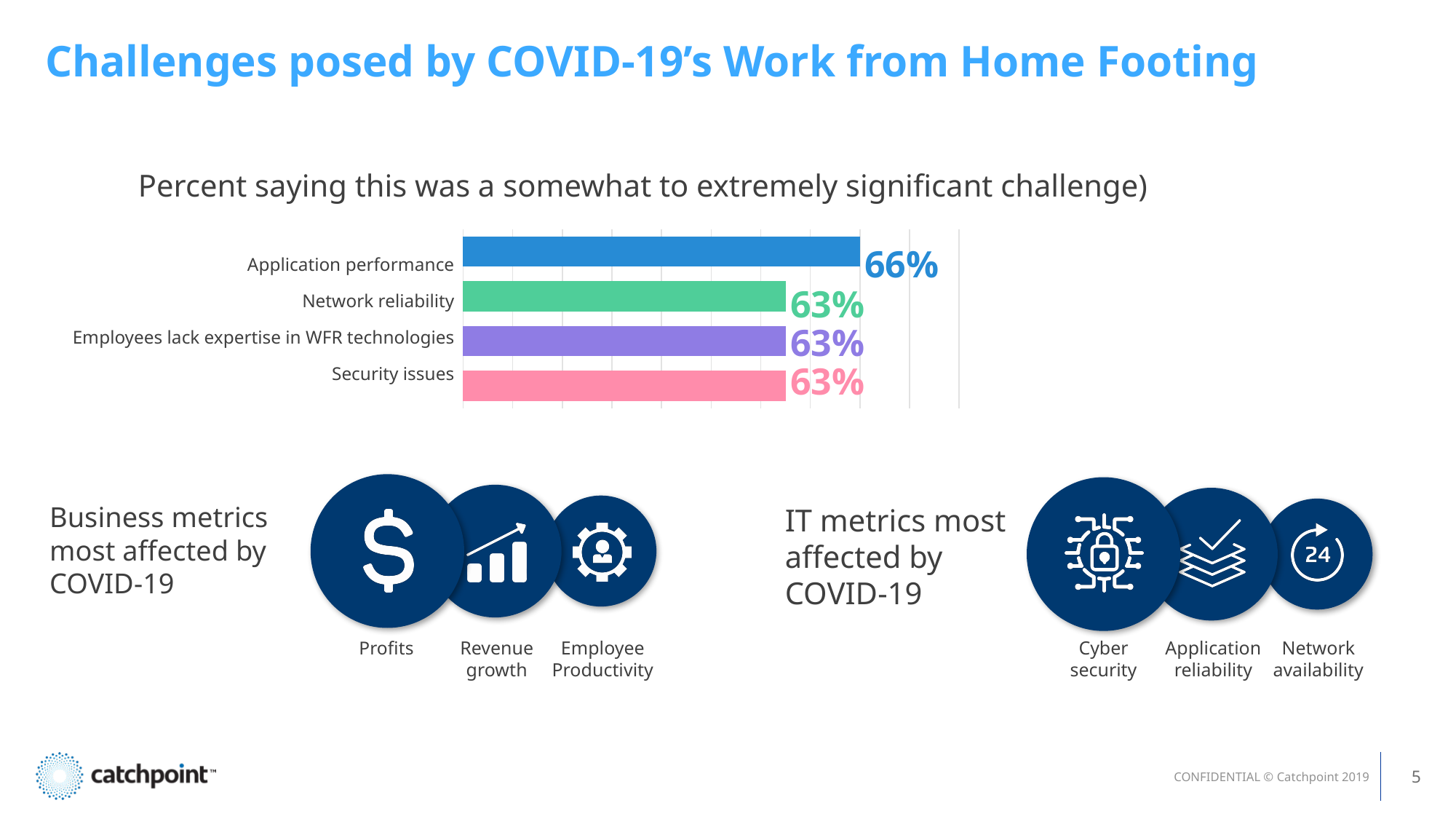
What is the value for Employees lack expertise in WFR technologies? 63% What is the difference between the values for Application performance and Security issues? 3% What colour is the bar for Application performance? Blue What is the value for Application performance? 66% What is the title of the slide? Challenges posed by COVID-19's Work from Home Footing What kind of chart is shown on the slide? Bar chart Which is larger, the value for Application performance or the value for Network reliability? Application performance Which category has the highest value? Application performance What is the value for Network reliability? 63% What is the value for Security issues? 63% How many categories are shown in the chart? 4